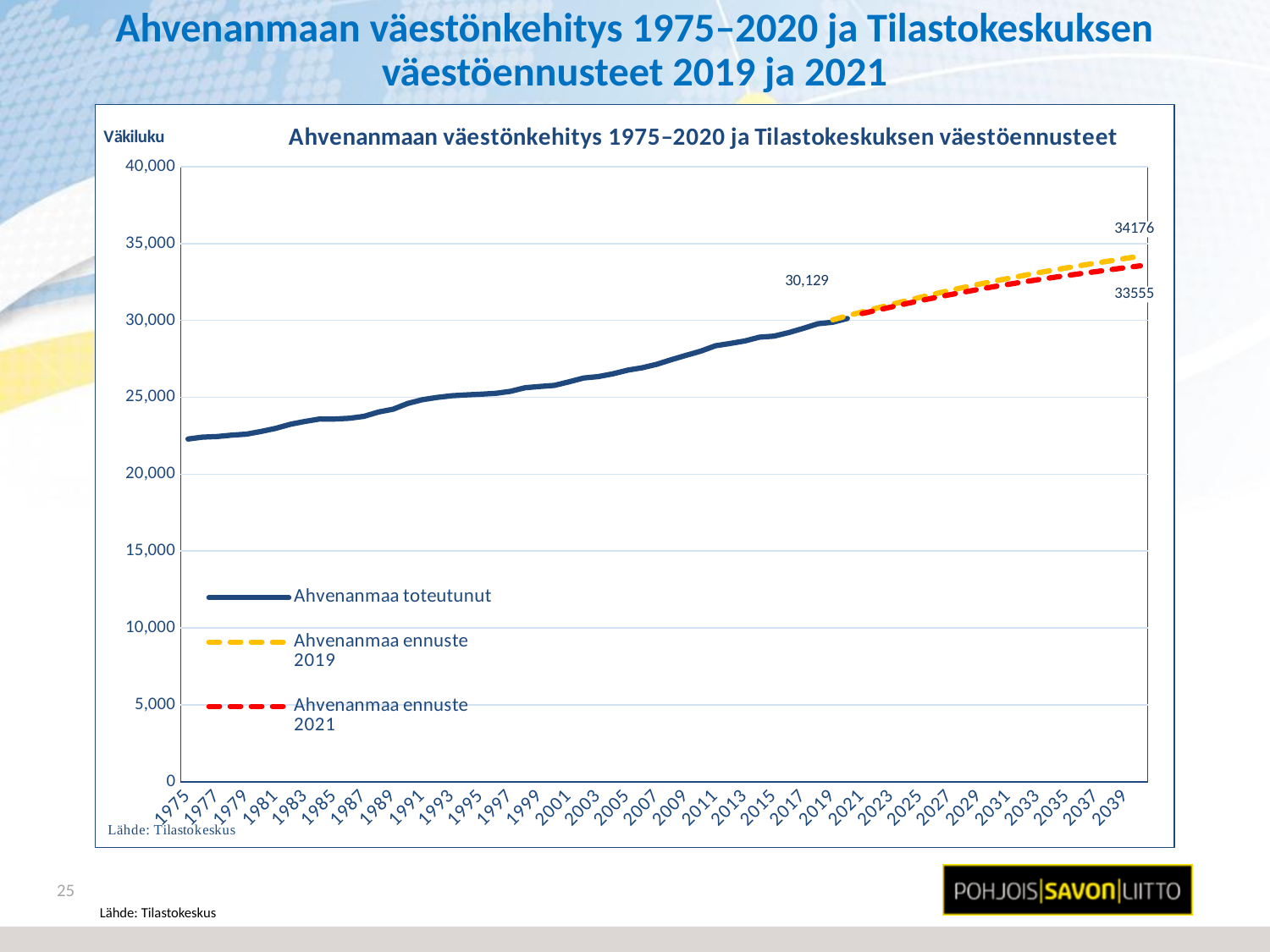
How many series does the legend list? 3 Which forecast series ends at a higher value, Ahvenanmaa ennuste 2019 or Ahvenanmaa ennuste 2021? Ahvenanmaa ennuste 2019 Does the Ahvenanmaa toteutunut line generally rise or fall from 1975 to 2020? Rise Is the population value for 2010 greater or less than 25,000? greater Is the population value for 1975 greater or less than 25,000? less What kind of chart is shown on the slide? Line chart What label is shown on the vertical axis of the chart? Väkiluku Which of the three labelled values on the chart is the highest? 34176 What is the final value shown for the Ahvenanmaa ennuste 2019 series? 34176 What is the final value shown for the Ahvenanmaa ennuste 2021 series? 33555 What is the difference between the end values of the 2019 forecast (34176) and the 2021 forecast (33555)? 621 What is the data label shown at the end of the Ahvenanmaa toteutunut (actual) line? 30,129